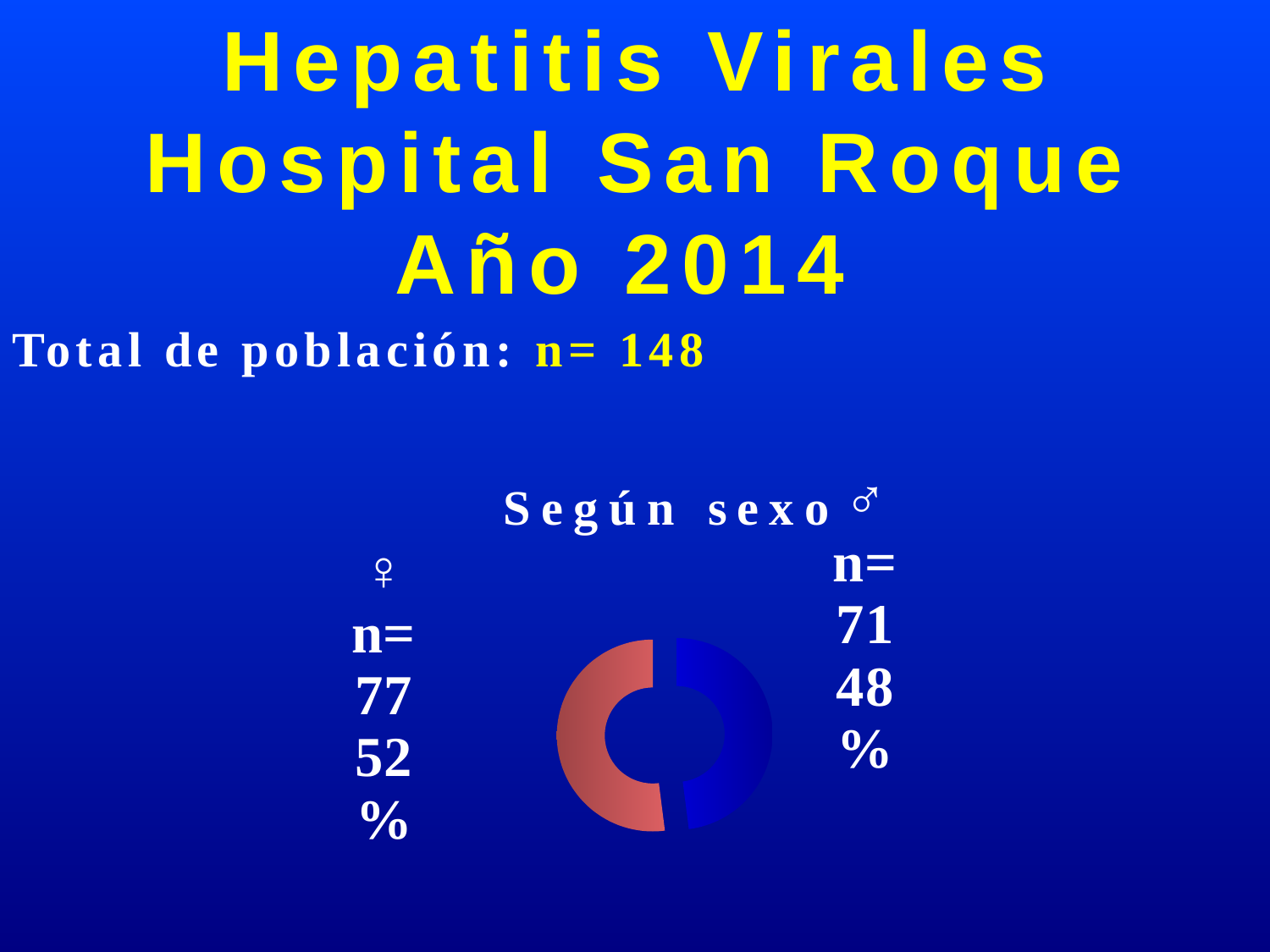
What is the difference in percentage points between the female and male shares? 4 How many patients are male (♂) according to the chart? n= 71 What is the total population stated on the slide? n= 148 What kind of chart is shown under the heading "Según sexo"? Doughnut chart How many categories does the doughnut chart divide the population into? 2 Which sex has the smaller share of the population in the chart? Male (♂) What percentage of the population is male (♂)? 48% What percentage of the population is female (♀)? 52% How many more female than male patients are there? 6 Which sex has the larger share of the population in the chart? Female (♀) Which colour represents the female (♀) segment of the doughnut chart? Red How many patients are female (♀) according to the chart? n= 77